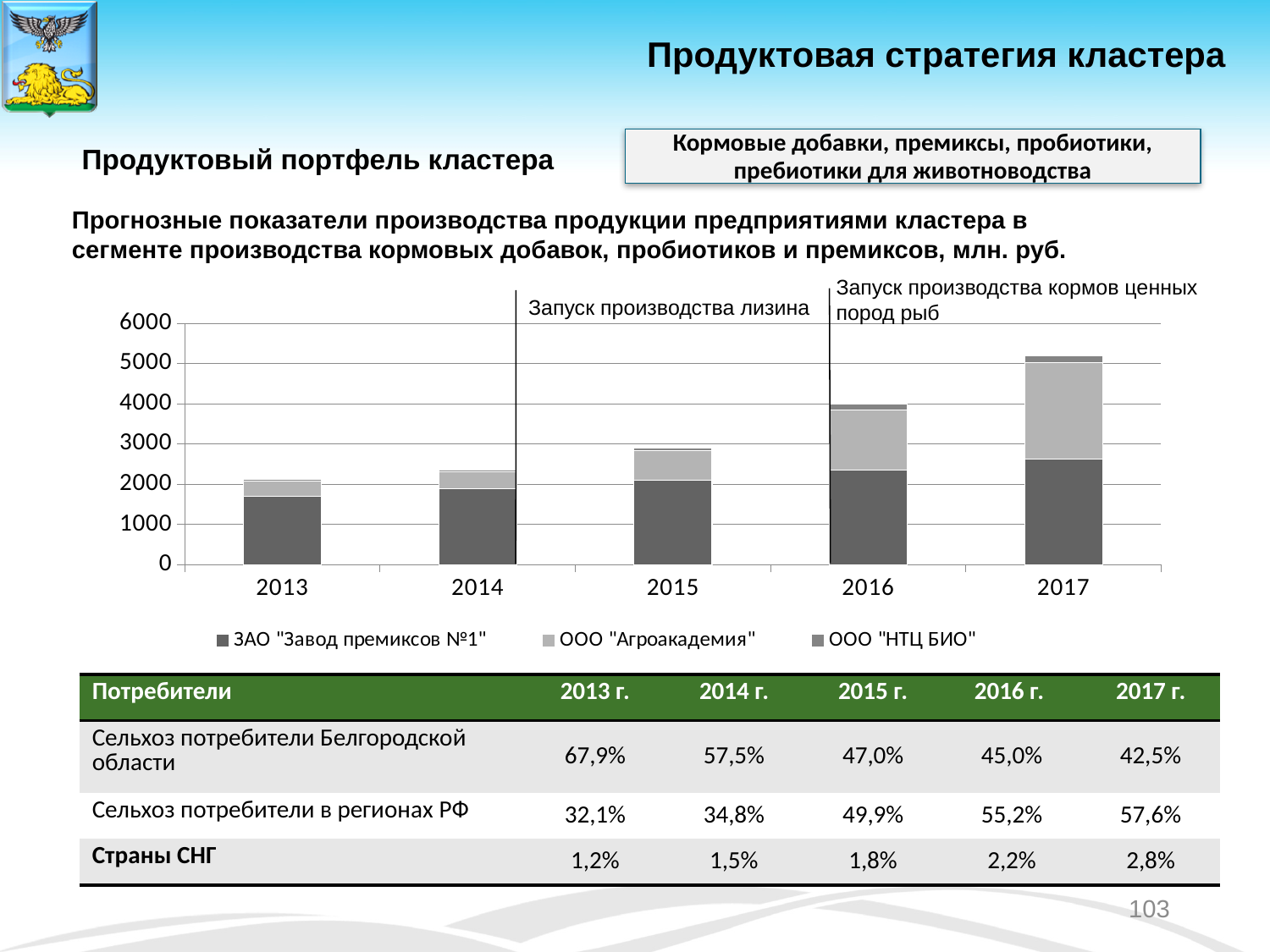
What kind of chart is shown on the slide? Stacked bar chart Which year has the highest total bar in the chart? 2017 Which series is listed first in the chart legend? ЗАО "Завод премиксов №1" Is the total bar for 2013 greater or less than 2000? greater Is the total bar for 2017 greater or less than 5000? greater What event is annotated on the chart between 2014 and 2015? Запуск производства лизина Do the total bar heights rise or fall from 2013 to 2017? Rise How many series does the chart legend list? 3 How many years are shown on the x axis of the chart? 5 Which year has the lowest total bar in the chart? 2013 Is the ЗАО "Завод премиксов №1" segment for 2013 greater or less than 2000? less